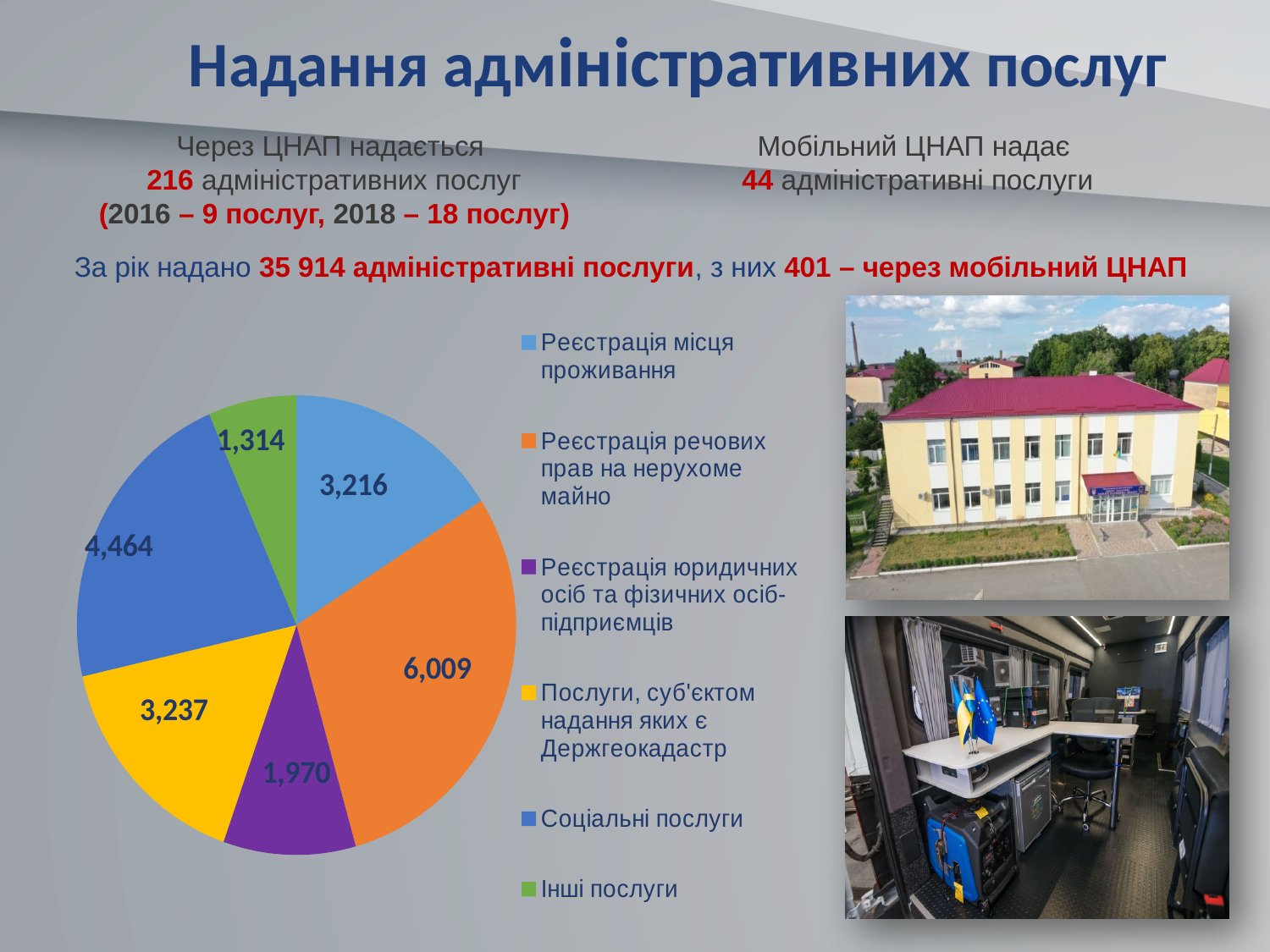
What is the value for Інші послуги in the pie chart? 1,314 Which is larger in the pie chart: Соціальні послуги or Реєстрація місця проживання? Соціальні послуги How many entries does the legend of the pie chart list? 6 What is the value for Соціальні послуги in the pie chart? 4,464 How many slices does the pie chart have? 6 Which category has the smallest slice in the pie chart? Інші послуги Which category has the largest slice in the pie chart? Реєстрація речових прав на нерухоме майно What is the difference between the values for Реєстрація речових прав на нерухоме майно and Соціальні послуги? 1,545 What kind of chart is shown on the slide? pie chart What is the value for Реєстрація юридичних осіб та фізичних осіб-підприємців in the pie chart? 1,970 What is the value for Реєстрація речових прав на нерухоме майно in the pie chart? 6,009 What colour is the slice for Послуги, суб'єктом надання яких є Держгеокадастр? yellow